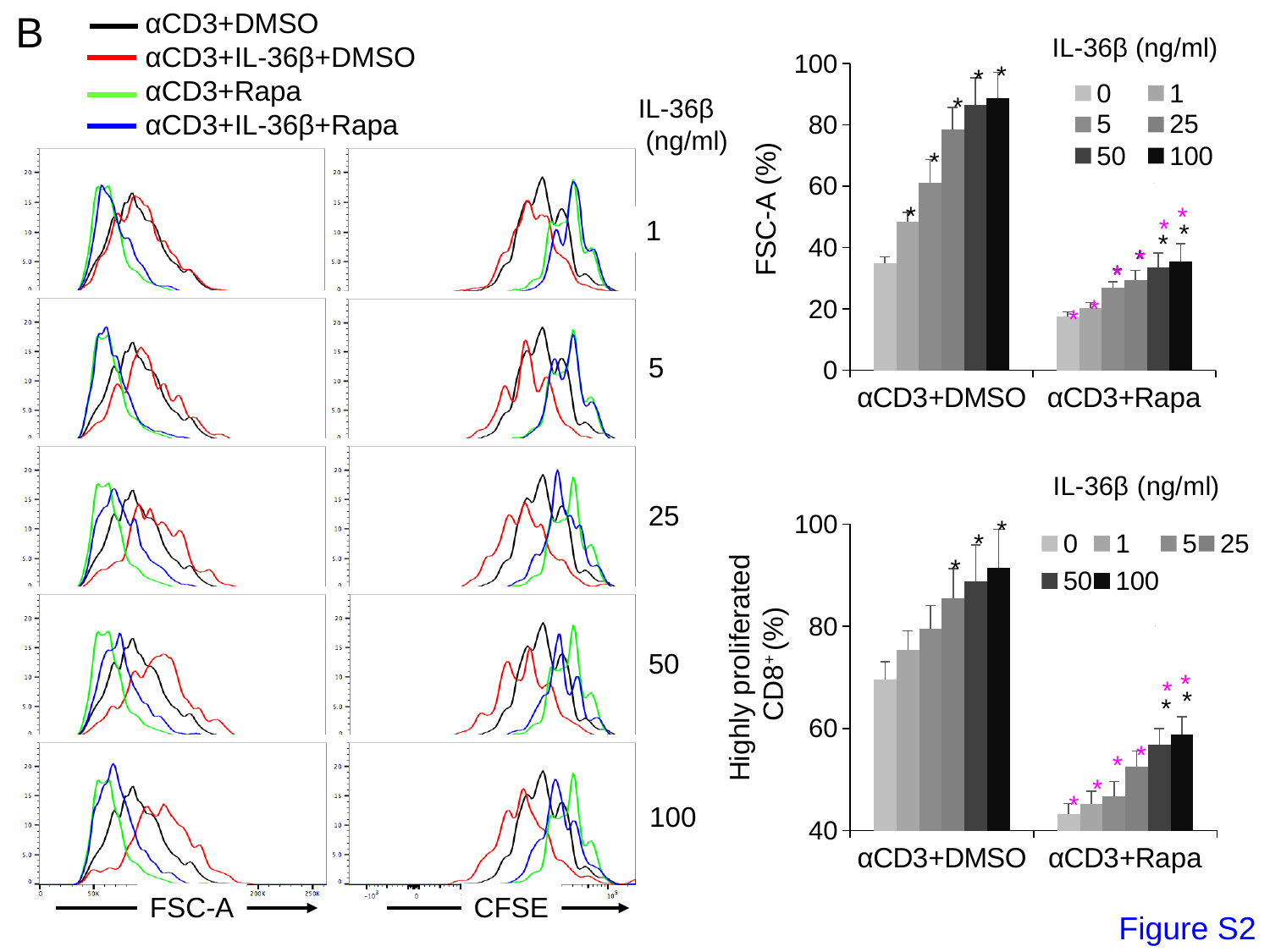
In the top right chart (FSC-A (%)), which treatment group contains the highest bar? αCD3+DMSO In the top right chart (FSC-A (%)), how many treatment groups are shown on the x axis? 2 In the top right chart (FSC-A (%)), which IL-36β concentration is shown in black in the legend? 100 In the top right chart (FSC-A (%)), is the value for αCD3+DMSO at 100 ng/ml IL-36β greater or less than 80? greater In the top right chart (FSC-A (%)), is the value for αCD3+DMSO at 0 ng/ml IL-36β greater or less than 40? less In the top right chart (FSC-A (%)), do the αCD3+DMSO bars rise or fall as the IL-36β concentration increases? rise In the top right chart (FSC-A (%)), how many IL-36β concentrations does the legend list? 6 In the bottom right chart (Highly proliferated CD8+ (%)), is the value for αCD3+DMSO at 0 ng/ml IL-36β greater or less than 60? greater In the bottom right chart (Highly proliferated CD8+ (%)), what is the lowest value shown on the y axis? 40 In the bottom right chart (Highly proliferated CD8+ (%)), which IL-36β concentration gives the lowest bar in the αCD3+Rapa group? 0 In the top right chart (FSC-A (%)), what kind of chart is it? bar chart In the top right chart (FSC-A (%)), which is larger at 100 ng/ml IL-36β: αCD3+DMSO or αCD3+Rapa? αCD3+DMSO